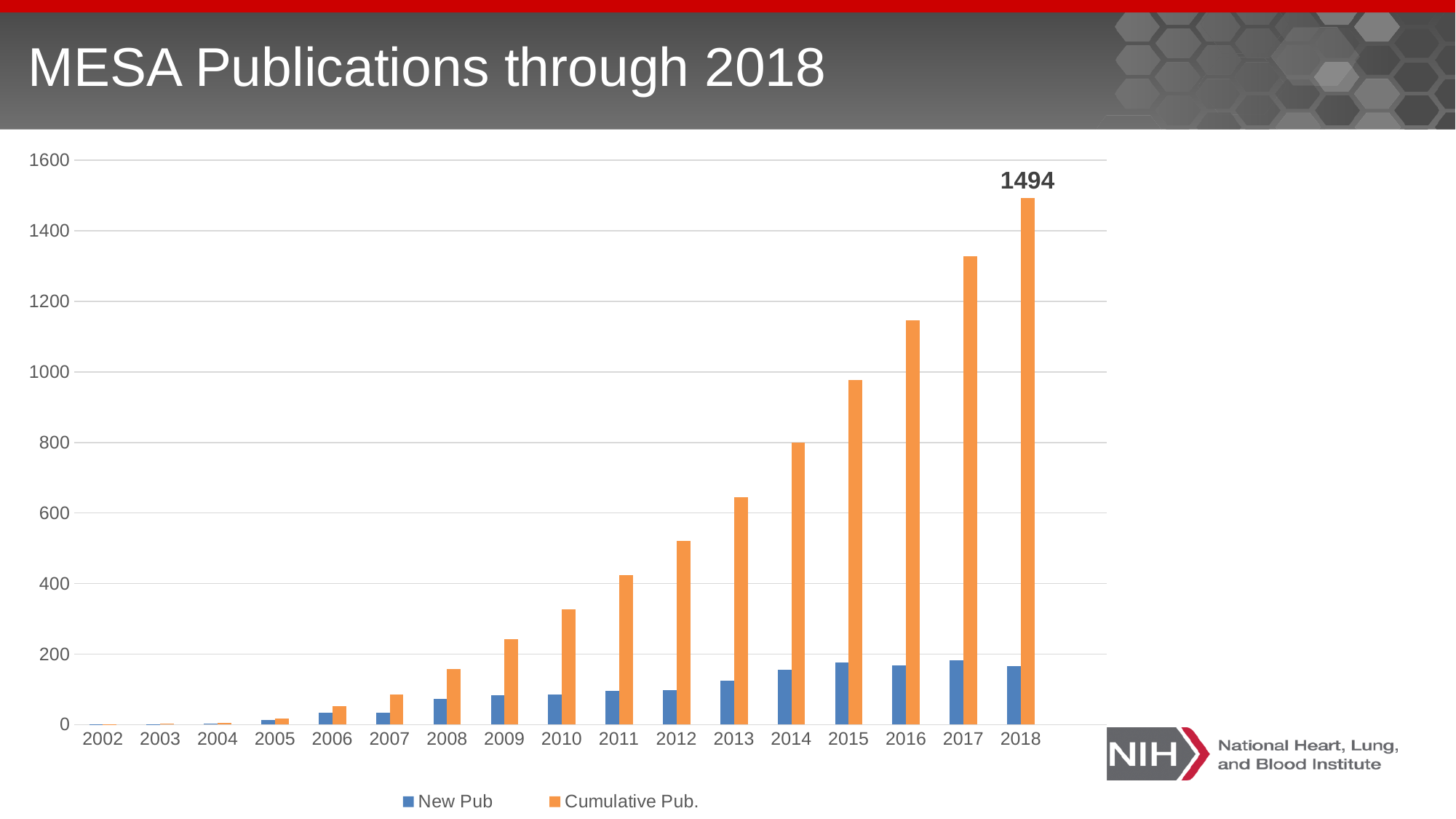
How many series does the legend list? 2 What is the value of the Cumulative Pub. bar for 2018? 1494 In 2018, which is larger: the New Pub bar or the Cumulative Pub. bar? Cumulative Pub. Is the Cumulative Pub. value for 2013 greater or less than 600? greater Is the New Pub value for 2017 greater or less than 200? less What kind of chart is shown on the slide? Bar chart How many years are shown on the x axis? 17 Which year has the highest Cumulative Pub. value? 2018 Is the Cumulative Pub. value for 2015 greater or less than 1000? less Which year has the lowest Cumulative Pub. value? 2002 Do the Cumulative Pub. values rise or fall from 2002 to 2018? Rise